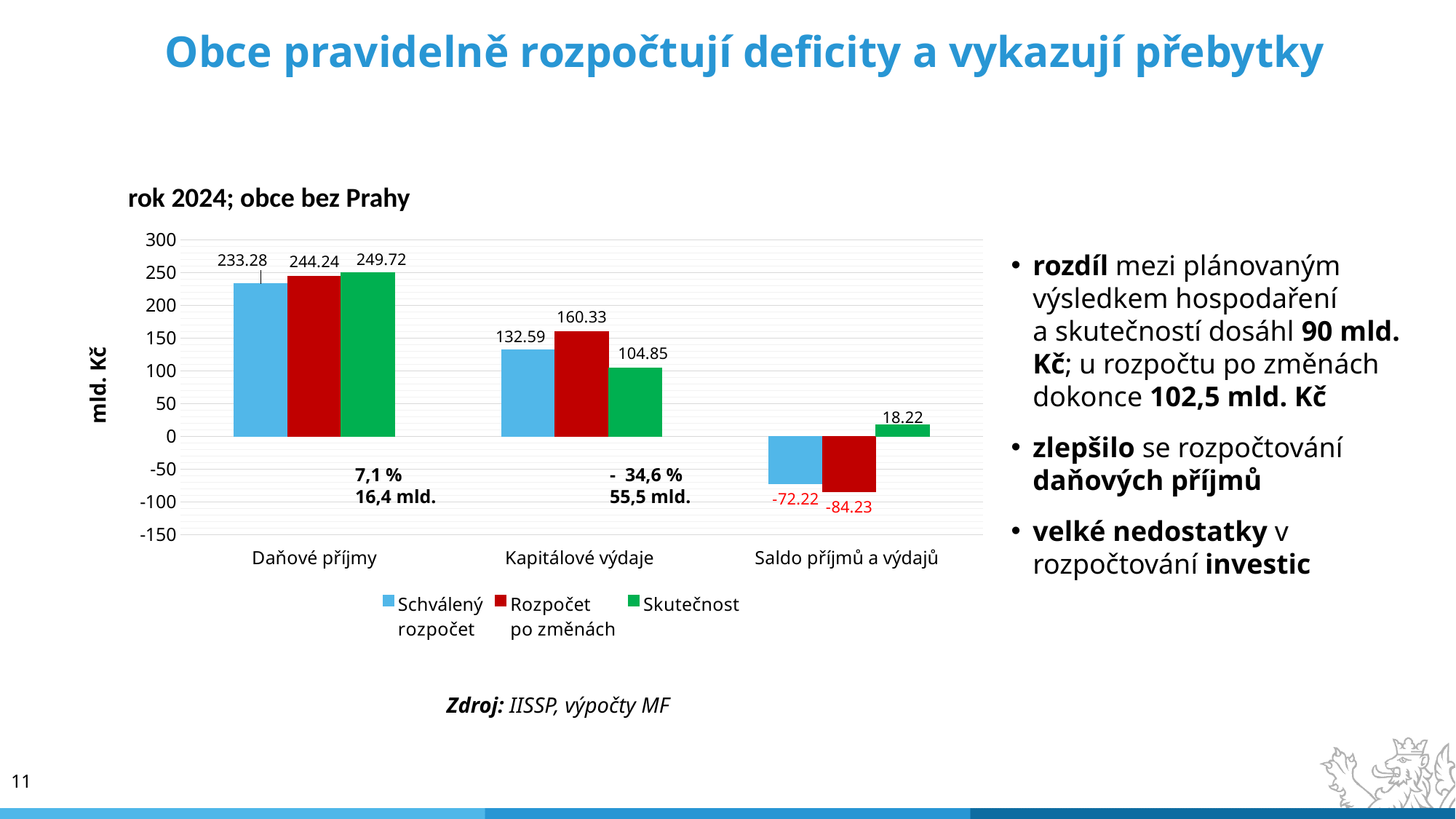
How many series does the legend list? 3 What is the value of Skutečnost for Daňové příjmy? 249.72 What is the value of Skutečnost for Saldo příjmů a výdajů? 18.22 Which series has the highest value for Kapitálové výdaje? Rozpočet po změnách Which is larger for Daňové příjmy: Schválený rozpočet or Rozpočet po změnách? Rozpočet po změnách What is the value of Rozpočet po změnách for Kapitálové výdaje? 160.33 Which series has the lowest value for Saldo příjmů a výdajů? Rozpočet po změnách What unit is shown on the y axis label? mld. Kč What is the difference between Rozpočet po změnách and Skutečnost for Kapitálové výdaje? 55.48 How many categories are shown on the x axis? 3 What is the value of Schválený rozpočet for Saldo příjmů a výdajů? -72.22 What kind of chart is shown on the slide? Bar chart